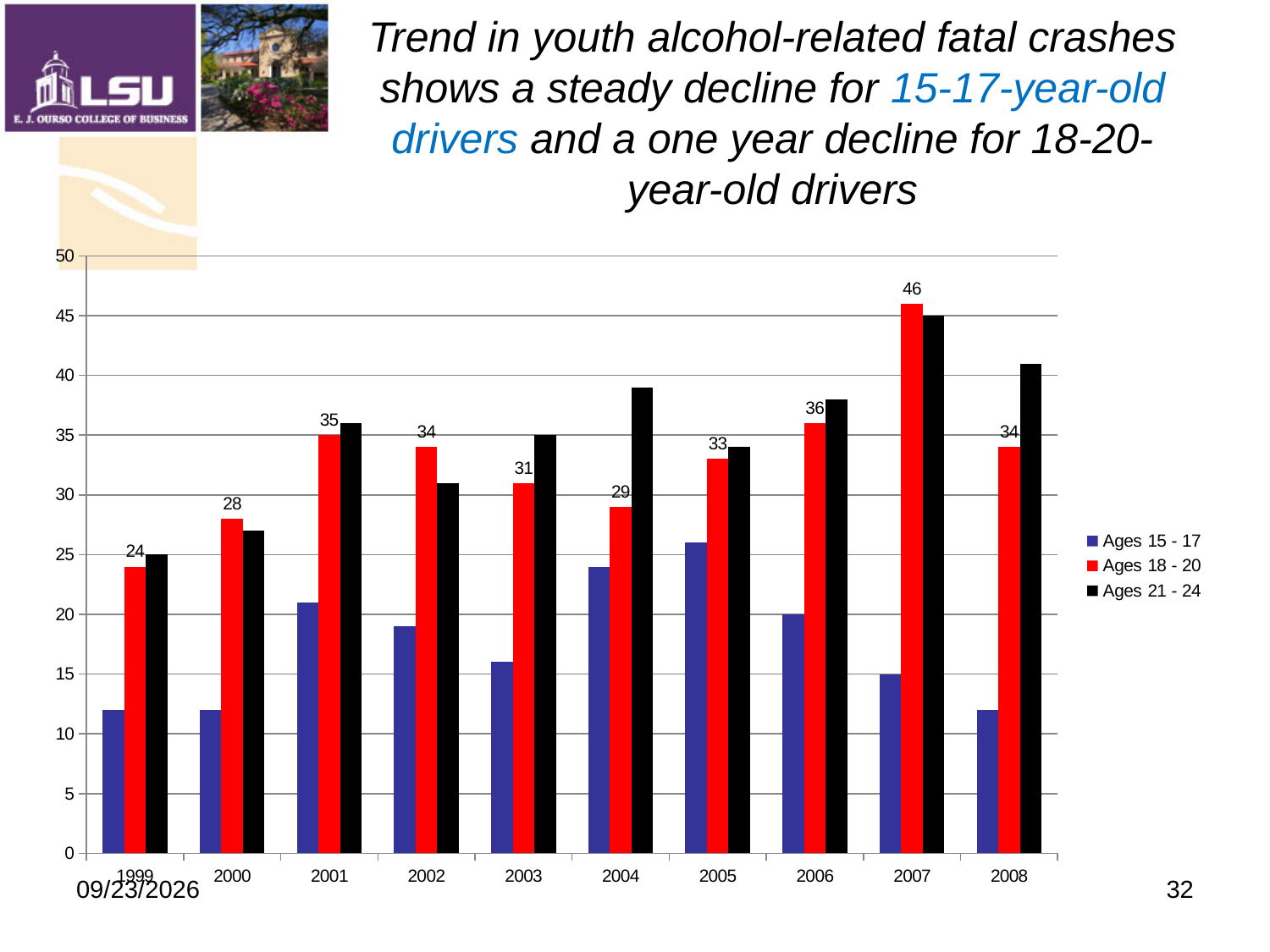
What is the value for Ages 18 - 20 in 2007? 46 How many years are shown on the x axis? 10 What kind of chart is shown on the slide? bar chart In which year is the value for Ages 18 - 20 lowest? 1999 Is the value for Ages 15 - 17 in 2005 greater or less than 20? greater How many series does the legend list? 3 Is the value for Ages 21 - 24 in 2007 greater or less than 40? greater What is the value for Ages 18 - 20 in 1999? 24 Which year has the larger value for Ages 18 - 20, 2001 or 2002? 2001 What is the difference between the Ages 18 - 20 values for 2007 and 2006? 10 In which year is the value for Ages 18 - 20 highest? 2007 Does the value for Ages 15 - 17 rise or fall from 2005 to 2008? fall